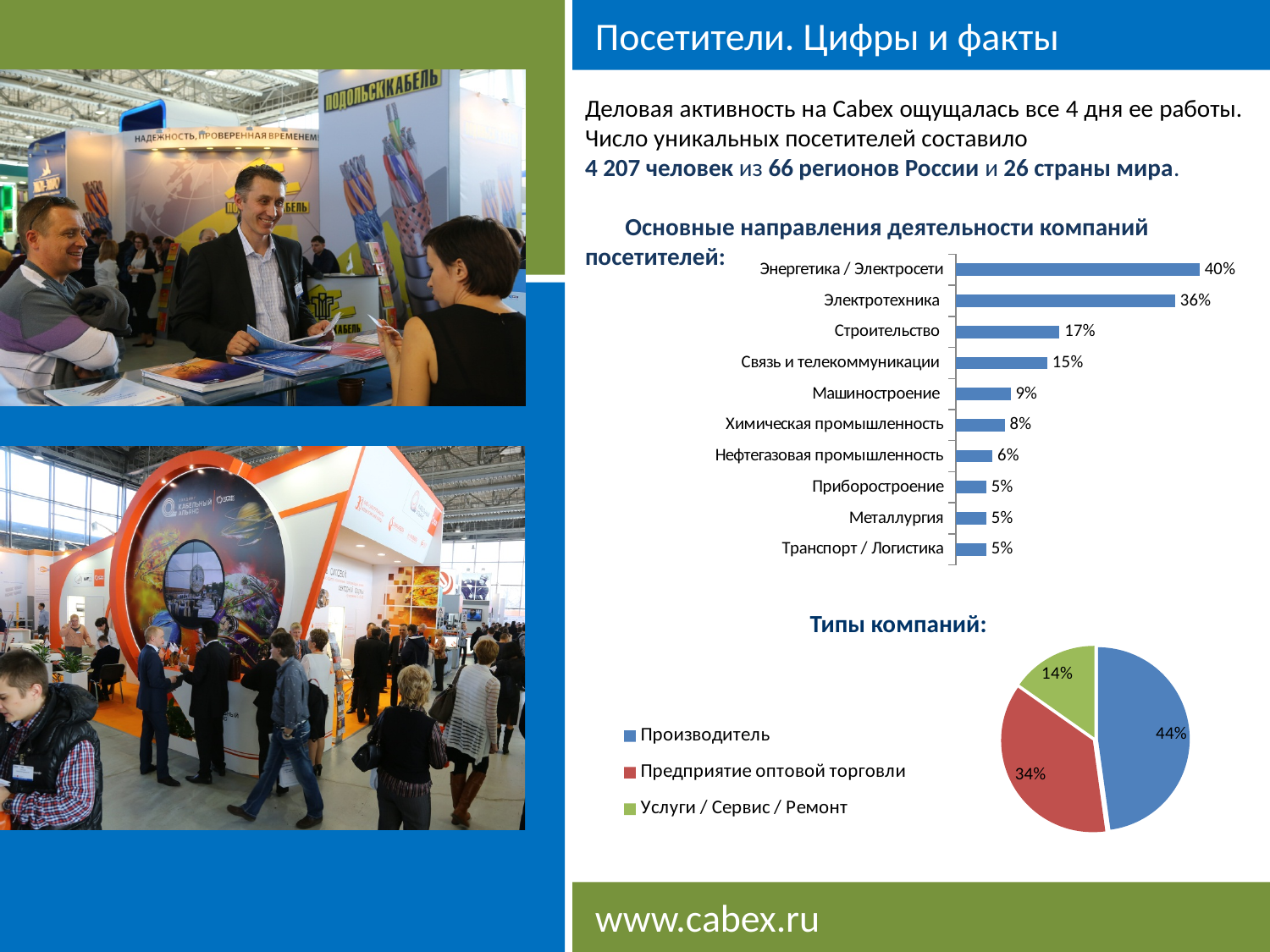
In the bar chart 'Основные направления деятельности компаний посетителей', what is the difference between Энергетика / Электросети and Строительство? 23% What kind of chart is 'Основные направления деятельности компаний посетителей'? Bar chart In the pie chart 'Типы компаний', what share does Услуги / Сервис / Ремонт have? 14% How many categories are shown in the bar chart 'Основные направления деятельности компаний посетителей'? 10 In the bar chart 'Основные направления деятельности компаний посетителей', what is the value for Связь и телекоммуникации? 15% In the pie chart 'Типы компаний', which category has the smallest share? Услуги / Сервис / Ремонт How many entries does the legend of the pie chart 'Типы компаний' list? 3 In the bar chart 'Основные направления деятельности компаний посетителей', which category has the highest value? Энергетика / Электросети In the bar chart 'Основные направления деятельности компаний посетителей', what is the value for Электротехника? 36% In the bar chart 'Основные направления деятельности компаний посетителей', what is the value for Нефтегазовая промышленность? 6% In the pie chart 'Типы компаний', what share does Производитель have? 44% In the bar chart 'Основные направления деятельности компаний посетителей', which is larger: Машиностроение or Химическая промышленность? Машиностроение